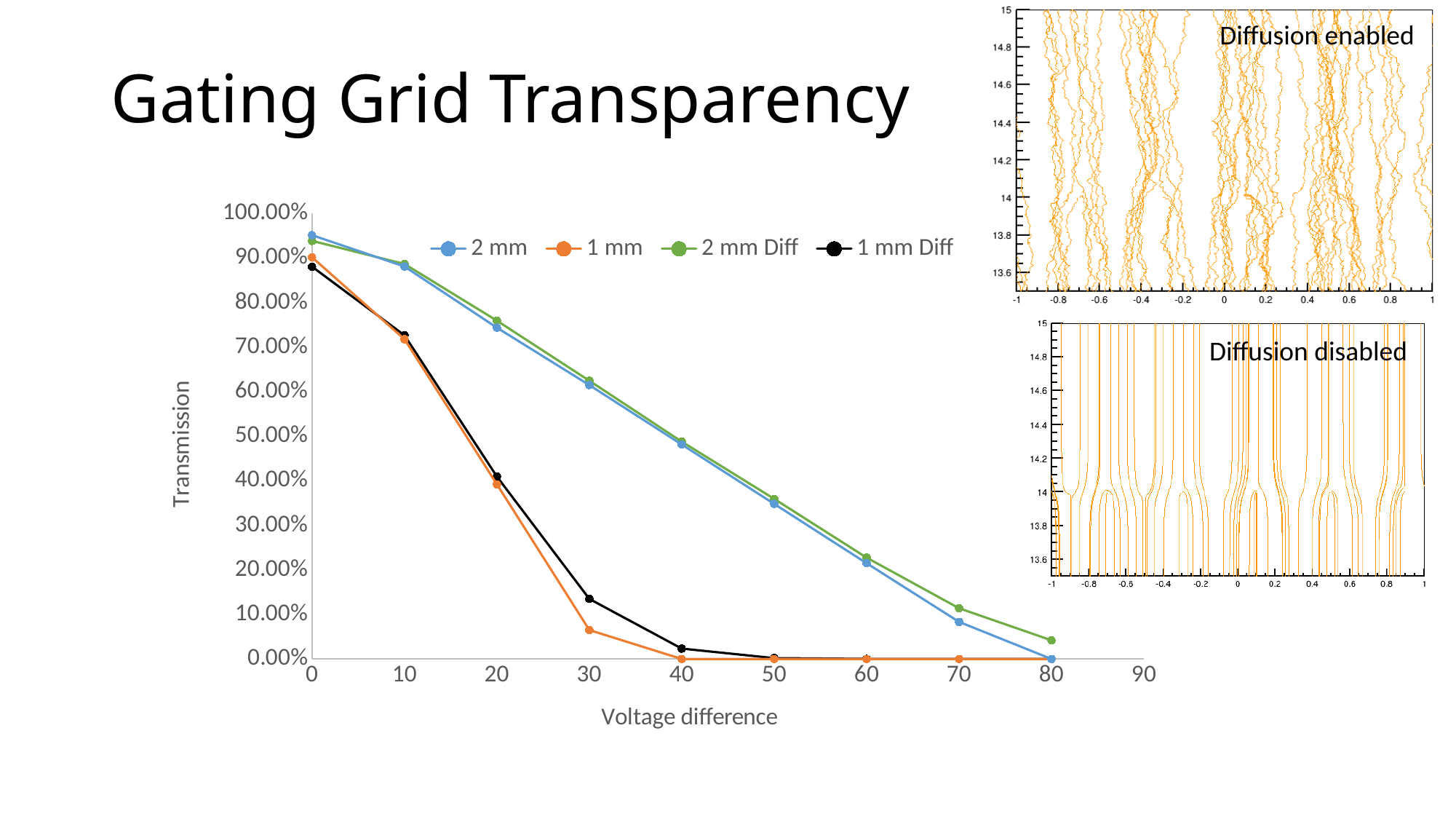
In the Transmission chart, at a voltage difference of 20, which series has the higher transmission: 2 mm or 1 mm? 2 mm Which colour is used for the 1 mm series in the Transmission chart? orange In the Transmission chart, at a voltage difference of 30, which series has the higher transmission: 1 mm or 1 mm Diff? 1 mm Diff How many data points are plotted for the 2 mm series in the Transmission chart? 9 In the Transmission chart, is the 2 mm Diff value at a voltage difference of 60 greater or less than 30.00%? less What kind of chart is the Transmission vs Voltage difference chart? line chart In the Transmission chart, is the 2 mm value at a voltage difference of 20 greater or less than 70.00%? greater In the Transmission chart, is the 1 mm value at a voltage difference of 10 greater or less than 80.00%? less How many series does the legend of the Transmission chart list? 4 What is the x-axis title of the Transmission chart? Voltage difference In the Transmission chart, do the values rise or fall as the voltage difference increases? fall